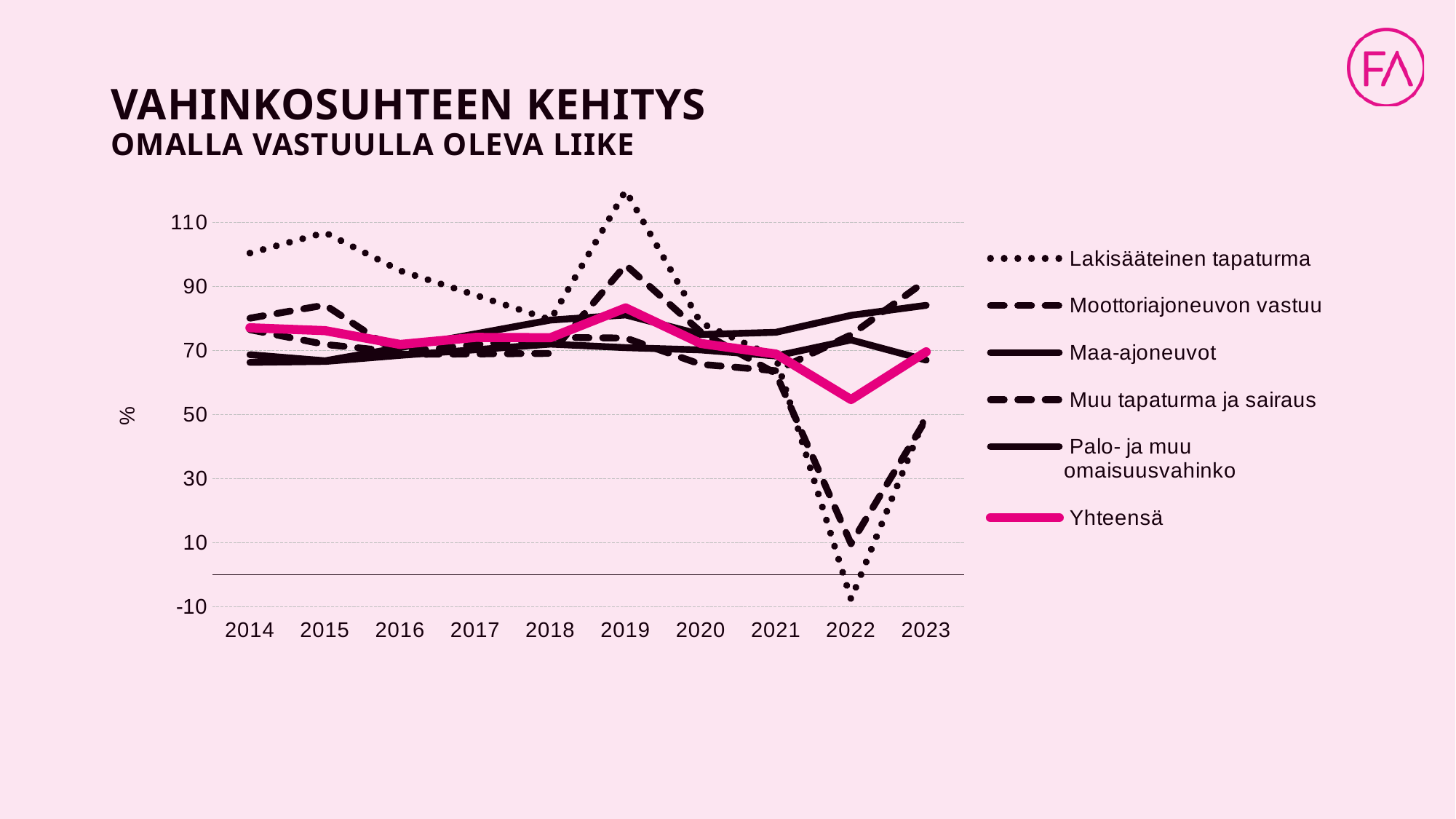
Is the value for Lakisääteinen tapaturma in 2019 greater or less than 110? greater In which year is the Yhteensä series at its lowest? 2022 How many series does the legend list? 6 In which year is the Yhteensä series at its highest? 2019 In 2019, which is larger: Lakisääteinen tapaturma or Moottoriajoneuvon vastuu? Lakisääteinen tapaturma Is the value for Lakisääteinen tapaturma in 2022 greater or less than 10? less Does the Lakisääteinen tapaturma series rise or fall from 2015 to 2018? fall Which series has the lowest value in 2022? Lakisääteinen tapaturma What kind of chart is shown on the slide? line chart Is the value for Yhteensä in 2022 greater or less than 70? less How many years are shown on the x axis? 10